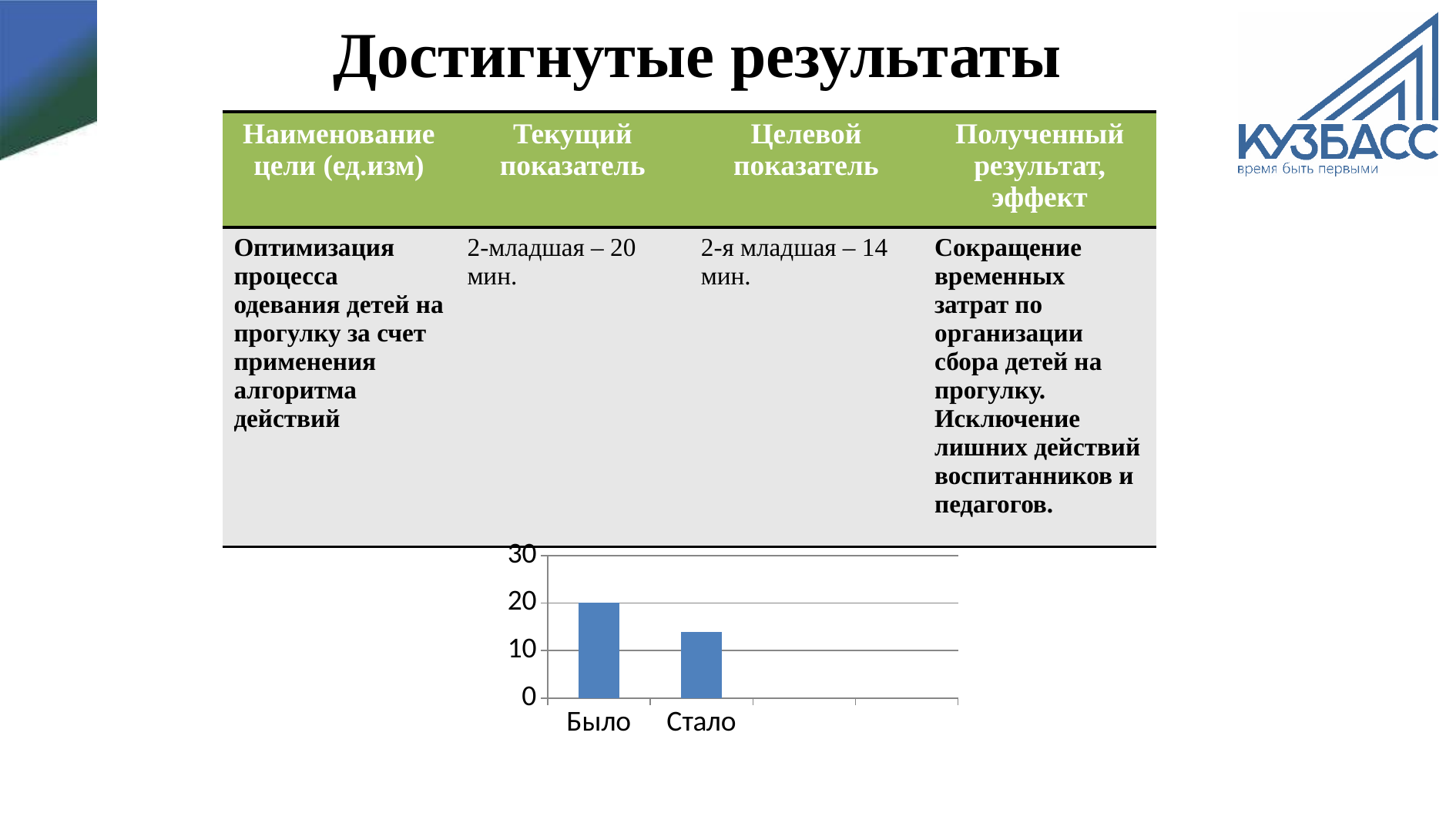
Do the bar values rise or fall from Было to Стало? fall Which is larger, the bar for Было or the bar for Стало? Было How many bars does the chart show? 2 What kind of chart is shown at the bottom of the slide? bar chart What is the highest value shown on the vertical axis of the chart? 30 Is the value for Стало greater or less than 10? greater Which category has the highest bar? Было Is the value for Стало greater or less than 20? less Which category has the lowest bar? Стало What colour are the bars in the chart? blue What is the value of the bar for Было? 20